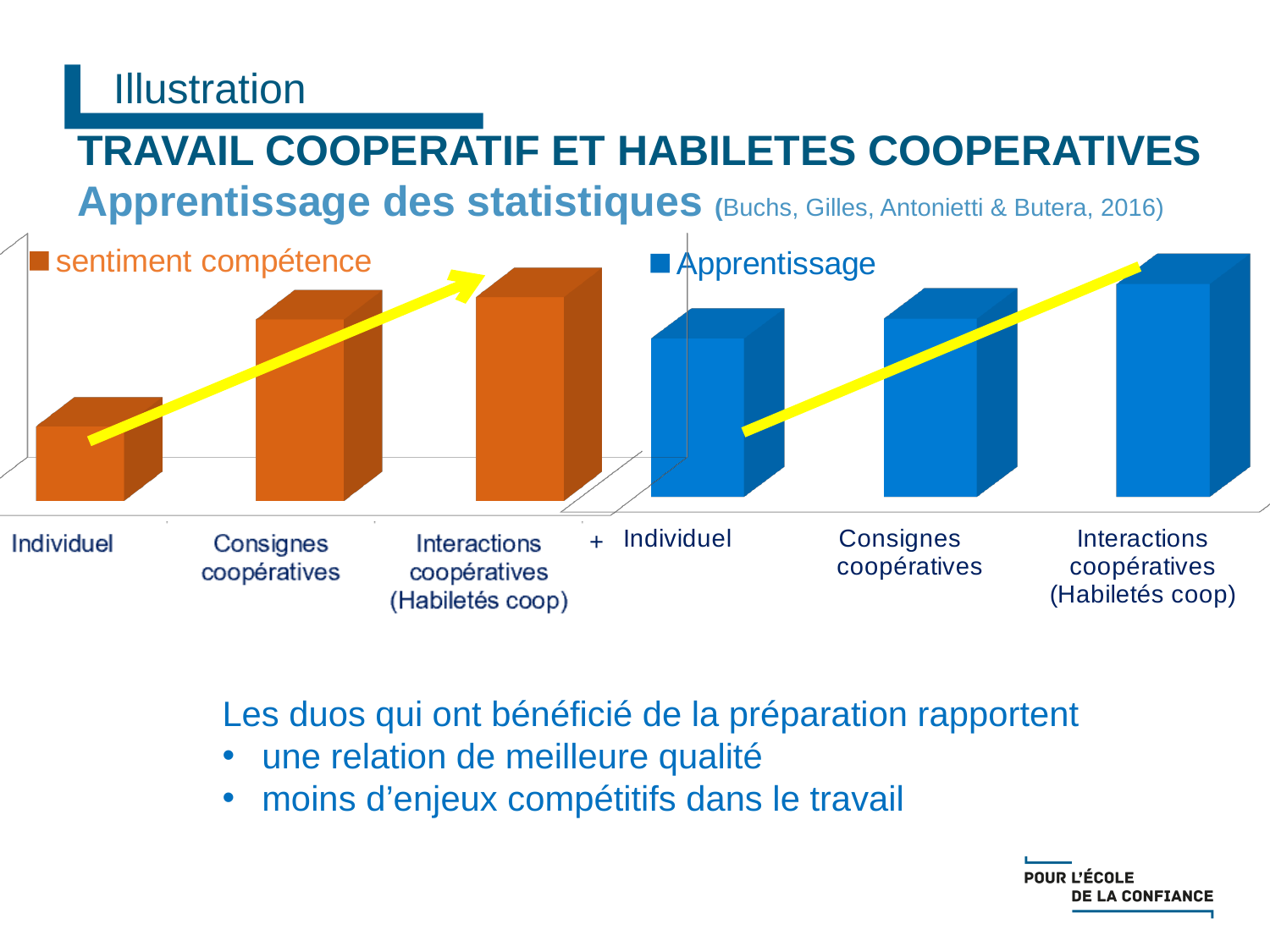
In the left chart ('sentiment compétence'), which category has the highest bar? Interactions coopératives (Habiletés coop) What colour are the bars in the left chart ('sentiment compétence')? orange In the left chart ('sentiment compétence'), how many categories are shown on the x axis? 3 In the left chart ('sentiment compétence'), do the bars rise or fall from left to right? rise In the right chart ('Apprentissage'), which category has the lowest bar? Individuel In the right chart ('Apprentissage'), do the bars rise or fall from left to right? rise In the right chart ('Apprentissage'), how many categories are shown on the x axis? 3 How many series does the legend of the right chart list? 1 In the left chart ('sentiment compétence'), which category has the lowest bar? Individuel What kind of chart is the left chart labelled 'sentiment compétence'? bar chart In the right chart ('Apprentissage'), which category has the highest bar? Interactions coopératives (Habiletés coop) In the left chart ('sentiment compétence'), which is larger: Individuel or Consignes coopératives? Consignes coopératives